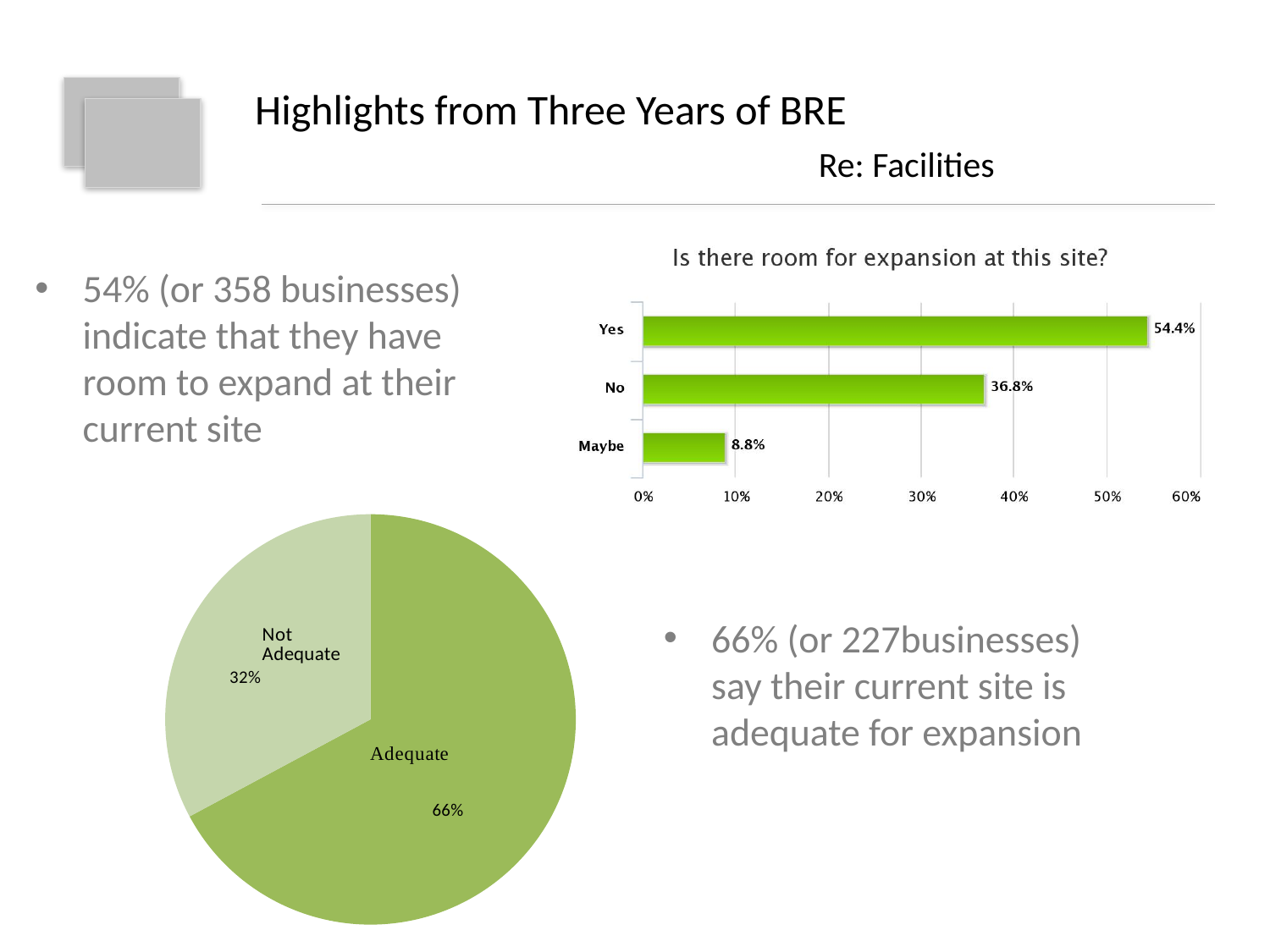
What kind of chart is the chart titled "Is there room for expansion at this site?"? bar chart In the bar chart titled "Is there room for expansion at this site?", which category has the lowest value? Maybe In the pie chart on the lower left, what share does the Adequate slice have? 66% In the bar chart titled "Is there room for expansion at this site?", how many categories are shown? 3 In the bar chart titled "Is there room for expansion at this site?", what is the value for Yes? 54.4% In the bar chart titled "Is there room for expansion at this site?", which category has the highest value? Yes In the bar chart titled "Is there room for expansion at this site?", what is the value for Maybe? 8.8% In the bar chart titled "Is there room for expansion at this site?", what is the difference between the Yes and No values? 17.6% In the bar chart titled "Is there room for expansion at this site?", what is the value for No? 36.8% What kind of chart is the chart on the lower left of the slide? pie chart In the pie chart on the lower left, which slice is larger, Adequate or Not Adequate? Adequate In the pie chart on the lower left, what share does the Not Adequate slice have? 32%